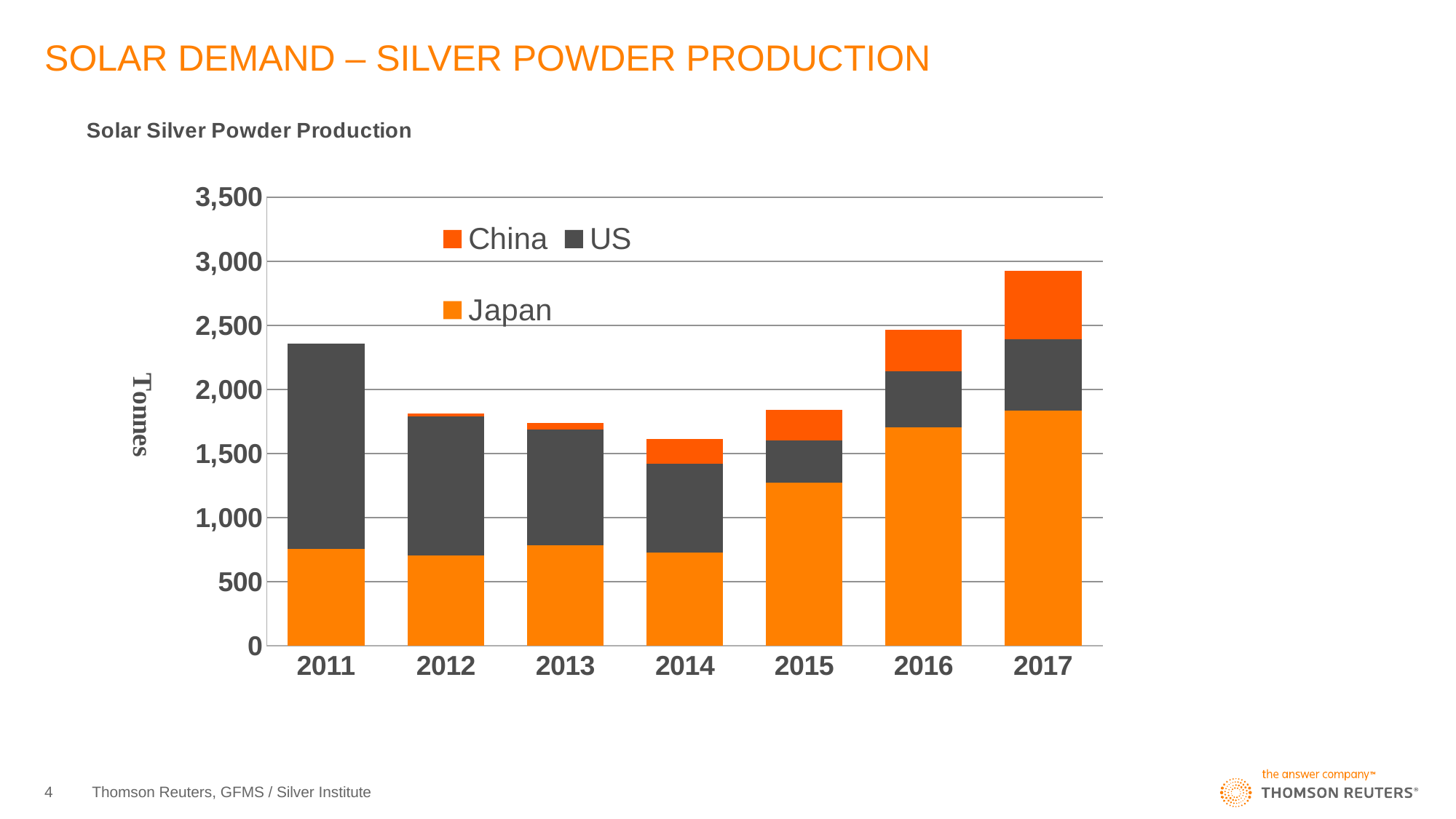
Is the total production for 2011 greater or less than 2,000 tonnes? greater Does the total production rise or fall from 2014 to 2017? Rise How many series does the chart's legend list? 3 Which is larger, the total production in 2017 or in 2011? 2017 Is the Japan value for 2011 greater or less than 1,000 tonnes? less What kind of chart is shown on the slide? Stacked bar chart Which year has the highest total solar silver powder production? 2017 Is the Japan value for 2017 greater or less than 1,500 tonnes? greater How many years are shown on the x axis of the chart? 7 What is the label on the y axis of the chart? Tonnes Which year has the lowest total solar silver powder production? 2014